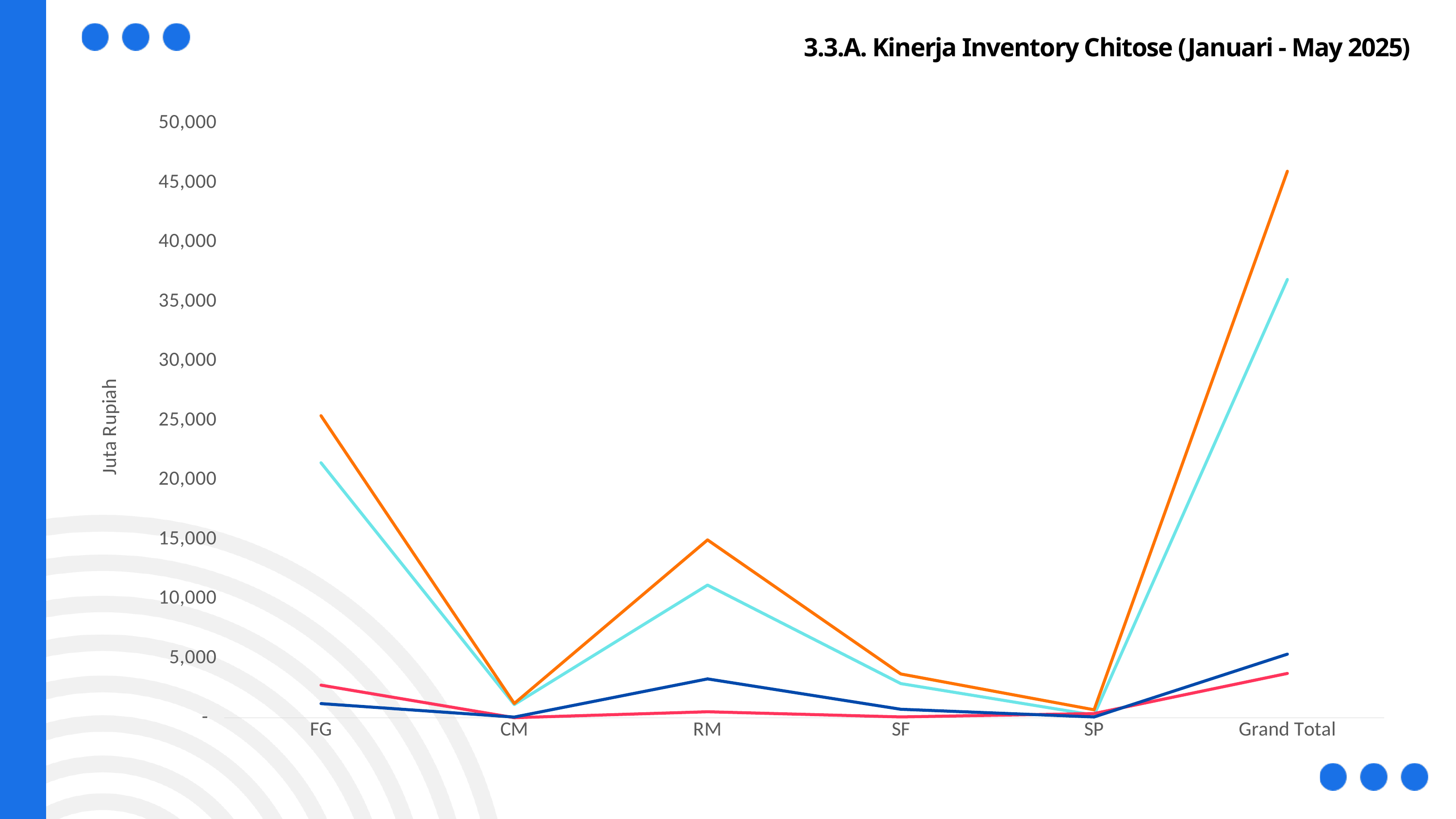
What is the title of the chart on the slide? 3.3.A. Kinerja Inventory Chitose (Januari - May 2025) For the orange line, is the value at FG or at RM larger? FG Is the value of the orange line at RM greater or less than 10,000? greater Is the value of the orange line at FG greater or less than 20,000? greater Is the value of the orange line at SF greater or less than 5,000? less How many categories are shown on the x axis of the chart? 6 What kind of chart is shown on the slide? line chart What is the label on the vertical axis of the chart? Juta Rupiah How many lines are plotted on the chart? 4 At which category does the orange line reach its highest value? Grand Total